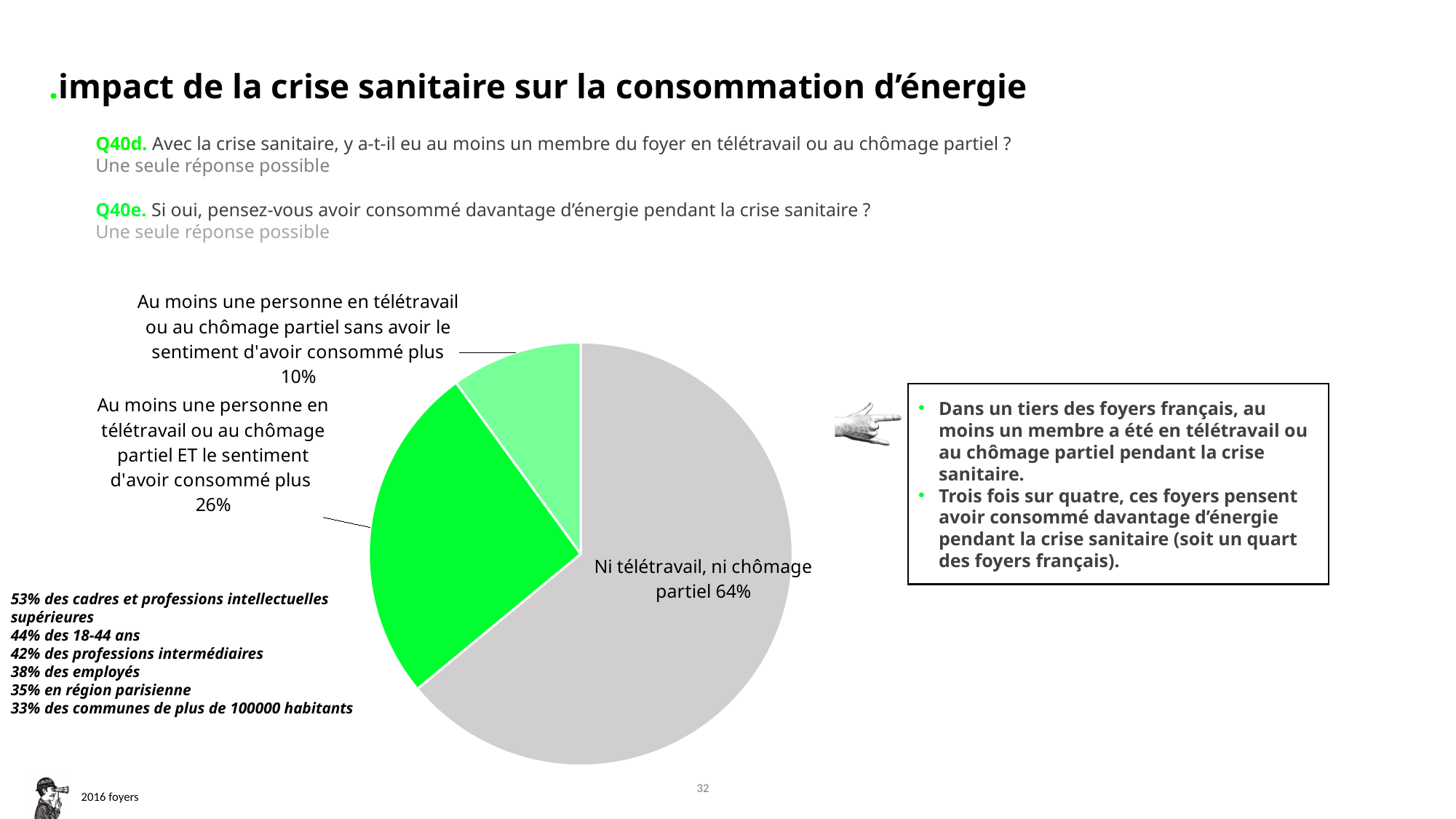
What share of the pie is 'Ni télétravail, ni chômage partiel'? 64% What is the difference between the 26% slice and the 10% slice? 16 percentage points Which slice of the pie chart is the smallest? Au moins une personne en télétravail ou au chômage partiel sans avoir le sentiment d'avoir consommé plus What kind of chart is shown on the slide? pie chart How many slices does the pie chart have? 3 What is the value for 'Au moins une personne en télétravail ou au chômage partiel ET le sentiment d'avoir consommé plus'? 26% Which is larger: the slice for households with someone in télétravail who feel they consumed more, or the slice for those who do not feel they consumed more? Those who feel they consumed more (26%) What is the difference between the 'Ni télétravail, ni chômage partiel' slice and the 26% slice? 38 percentage points Which slice of the pie chart is the largest? Ni télétravail, ni chômage partiel What colour is the 26% slice? bright green What is the value for 'Au moins une personne en télétravail ou au chômage partiel sans avoir le sentiment d'avoir consommé plus'? 10% What colour is the 'Ni télétravail, ni chômage partiel' slice? grey